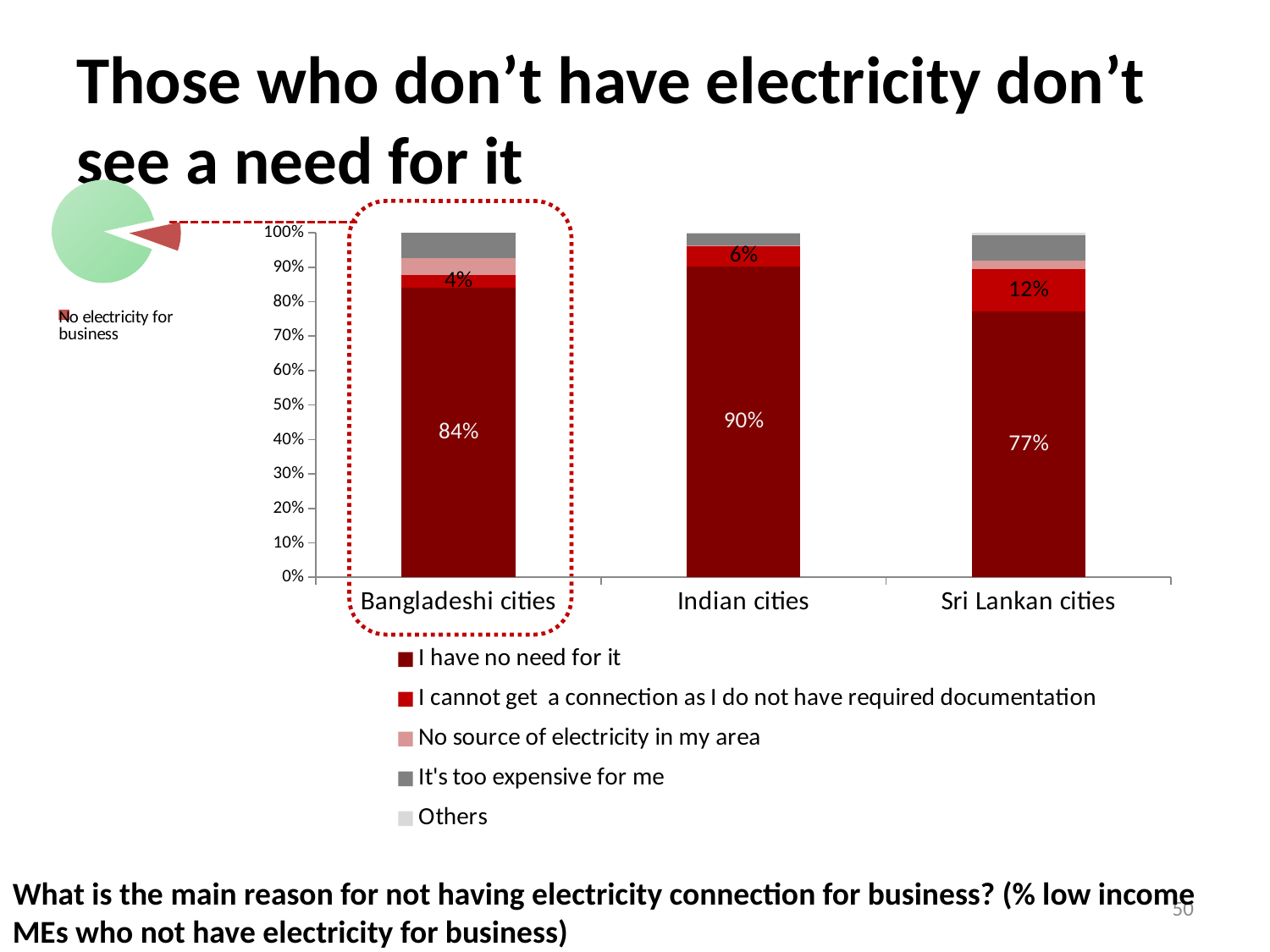
What percentage of respondents in Bangladeshi cities said "I have no need for it"? 84% What percentage of respondents in Sri Lankan cities said they cannot get a connection because they do not have the required documentation? 12% What is the value of "I have no need for it" for Indian cities? 90% What is the value of "I cannot get a connection as I do not have required documentation" for Indian cities? 6% Which city group has the highest share of respondents saying "I have no need for it"? Indian cities What is the difference in percentage points between Indian cities and Sri Lankan cities for "I have no need for it"? 13 percentage points What is the value of "I have no need for it" for Sri Lankan cities? 77% Which city group has the lowest share of respondents saying "I have no need for it"? Sri Lankan cities How many series does the legend of the stacked bar chart list? 5 What kind of chart is the main chart on the slide? Stacked bar chart How many city groups are shown on the x axis of the stacked bar chart? 3 Which has a larger share for "I cannot get a connection as I do not have required documentation": Indian cities or Sri Lankan cities? Sri Lankan cities